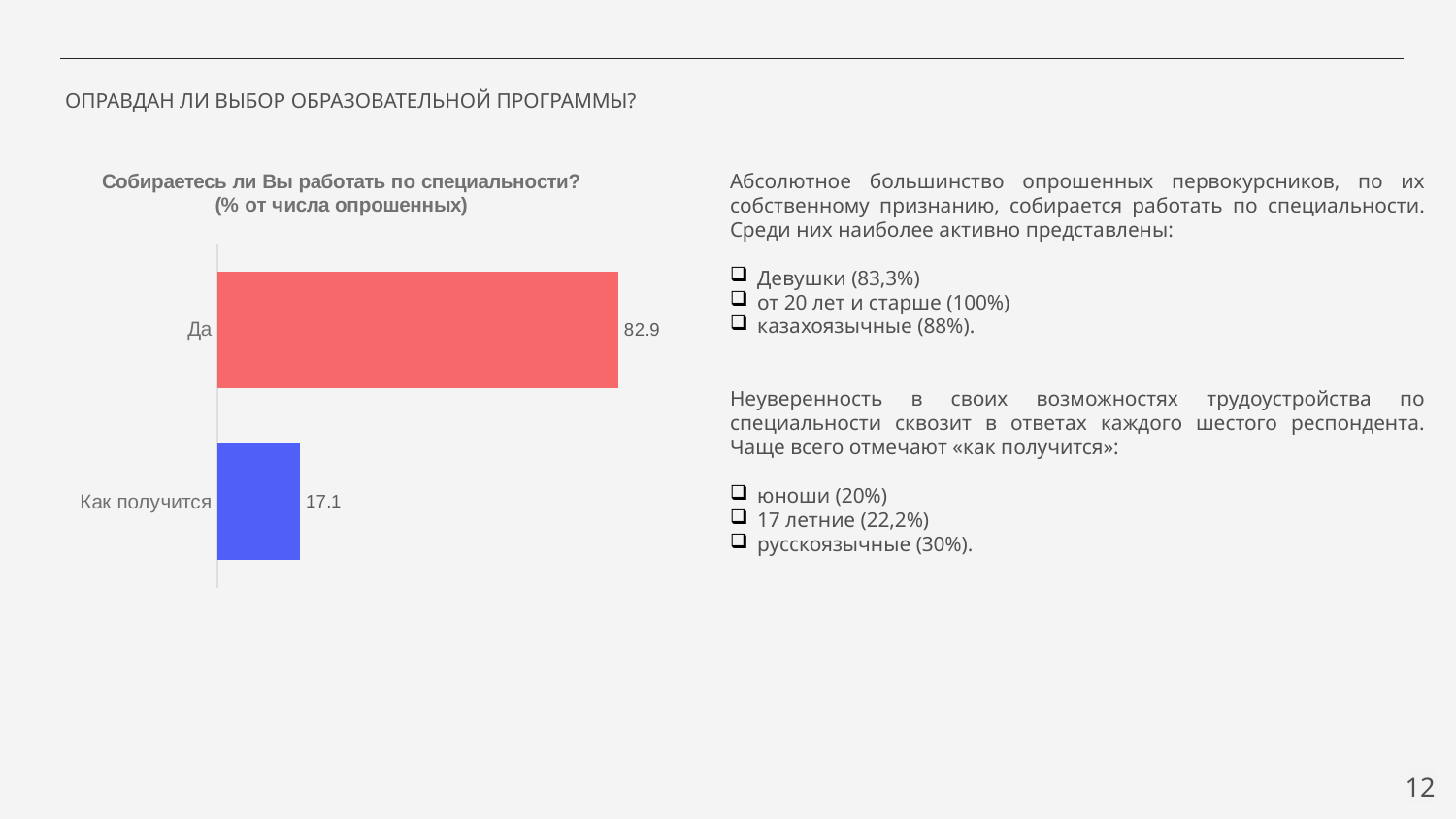
What kind of chart is shown on the slide? Bar chart Which category has the highest value? Да What is the value for "Как получится"? 17.1 What is the title of the chart? Собираетесь ли Вы работать по специальности? (% от числа опрошенных) How many categories are shown in the chart? 2 Which is larger, the value for "Да" or the value for "Как получится"? Да What is the total of the two values shown in the chart? 100 What colour is the bar for "Как получится"? Blue What is the difference between the values for "Да" and "Как получится"? 65.8 Which category has the lowest value? Как получится What is the value for "Да"? 82.9